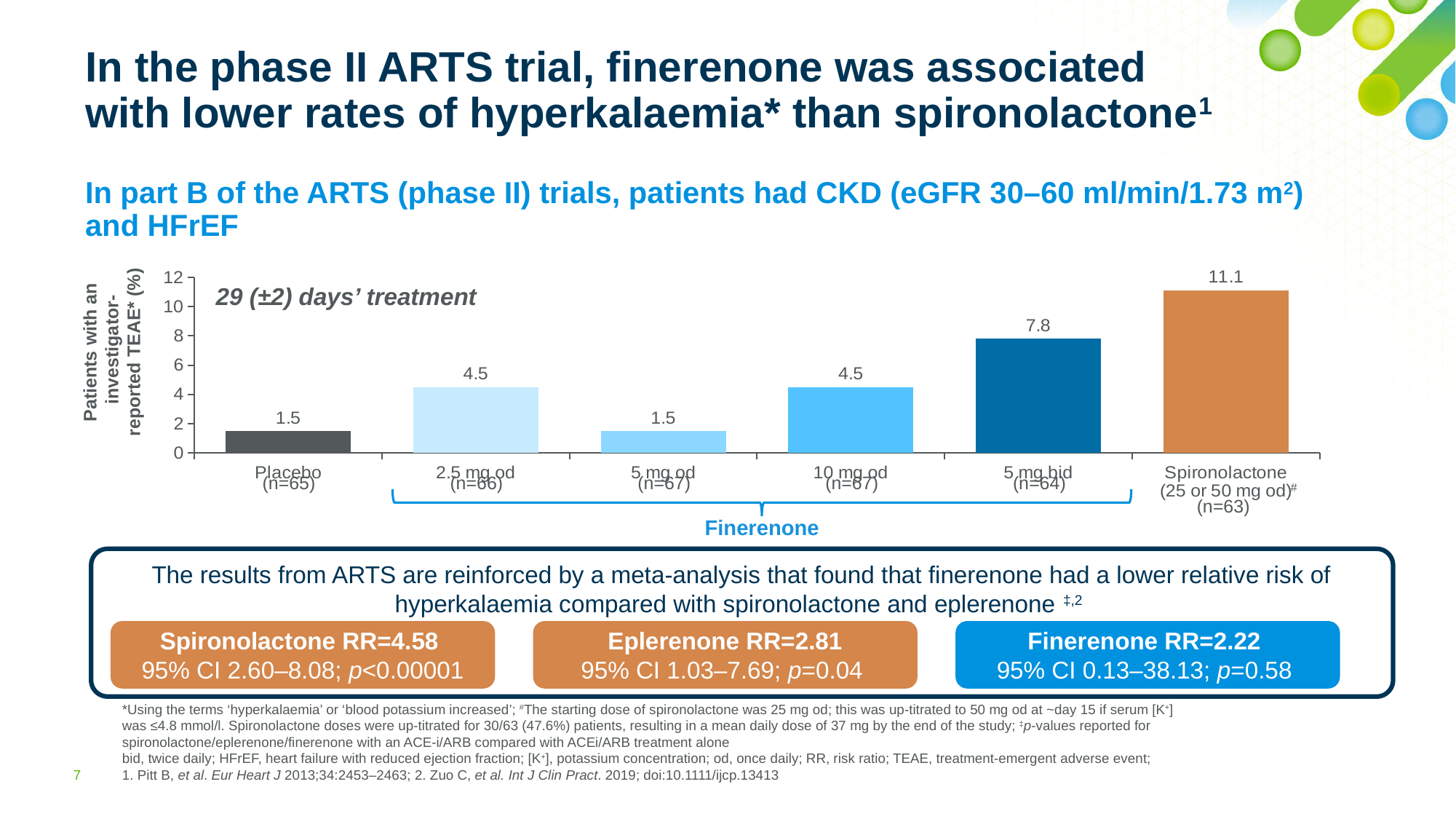
What is the value for Placebo (n=65)? 1.5 How many categories (bars) are shown in the chart? 6 What is the value for finerenone 2.5 mg od (n=66)? 4.5 What is the value for finerenone 5 mg bid (n=64)? 7.8 What is the difference between the finerenone 10 mg od value and the finerenone 5 mg od value? 3.0 Is the value for Spironolactone greater or less than 10? greater Which category has the highest percentage of patients with an investigator-reported TEAE? Spironolactone (25 or 50 mg od) What kind of chart is shown on the slide? bar chart What is the label of the y axis of the chart? Patients with an investigator-reported TEAE* (%) Which is larger, the value for finerenone 5 mg bid or the value for finerenone 10 mg od? finerenone 5 mg bid What is the value for Spironolactone (25 or 50 mg od) (n=63)? 11.1 What is the difference between the Spironolactone value and the finerenone 5 mg bid value? 3.3